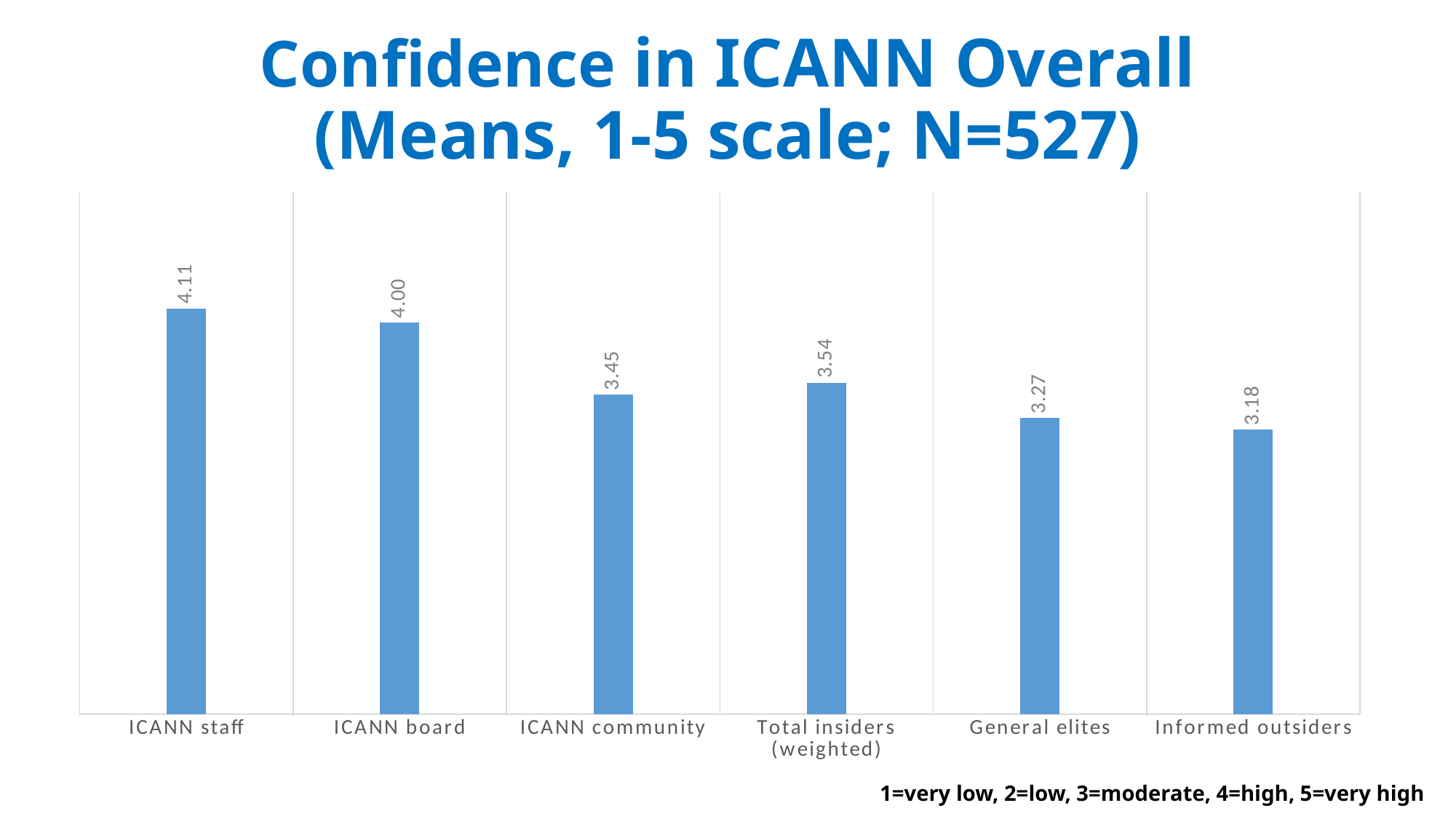
What is the title of the chart? Confidence in ICANN Overall (Means, 1-5 scale; N=527) Which category has the lowest mean confidence? Informed outsiders What is the value shown for Total insiders (weighted)? 3.54 Which category has the highest mean confidence? ICANN staff What is the mean confidence value for Informed outsiders? 3.18 What is the mean confidence value for ICANN staff? 4.11 According to the note on the slide, what does a value of 3 mean on the scale? moderate Which is larger, the value for ICANN community or the value for Total insiders (weighted)? Total insiders (weighted) What is the difference between the values for General elites and Informed outsiders? 0.09 What kind of chart is shown on the slide? Bar chart What is the difference between the values for ICANN staff and ICANN board? 0.11 How many categories are shown on the chart? 6